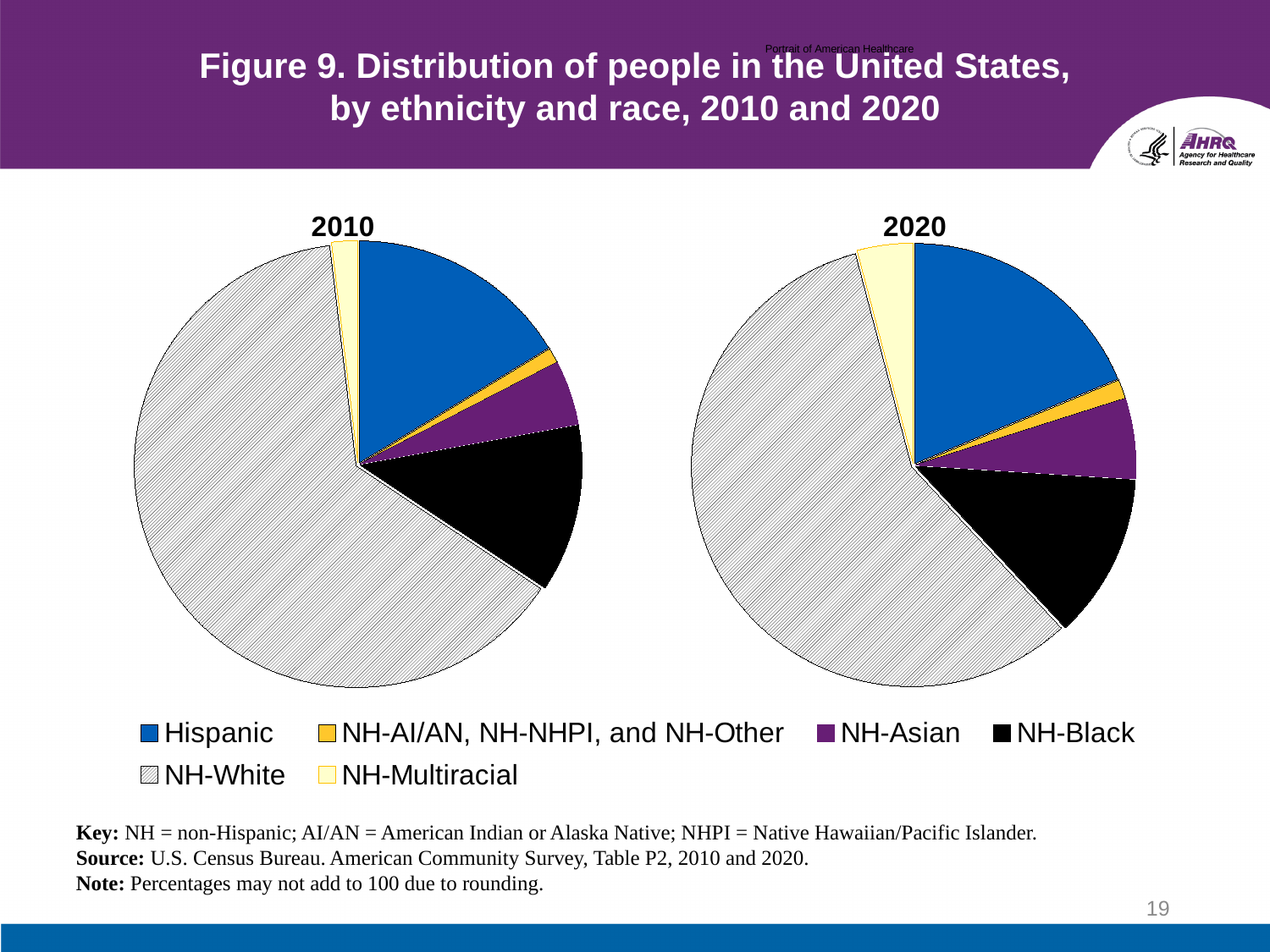
In the 2020 pie chart, which category has the largest slice? NH-White Is the NH-White slice larger in the 2010 pie chart or the 2020 pie chart? 2010 In the 2020 pie chart, which category has the smallest slice? NH-AI/AN, NH-NHPI, and NH-Other How many pie charts are on the slide? 2 Which category is shown with a hatched (diagonal line) pattern in the legend? NH-White What is the title of the figure on the slide? Figure 9. Distribution of people in the United States, by ethnicity and race, 2010 and 2020 Is the NH-Multiracial slice larger in the 2010 pie chart or the 2020 pie chart? 2020 How many categories does the legend list? 6 In the 2010 pie chart, which slice is larger, Hispanic or NH-Black? Hispanic In the 2010 pie chart, which category has the largest slice? NH-White What kind of charts are shown on the slide? Pie charts